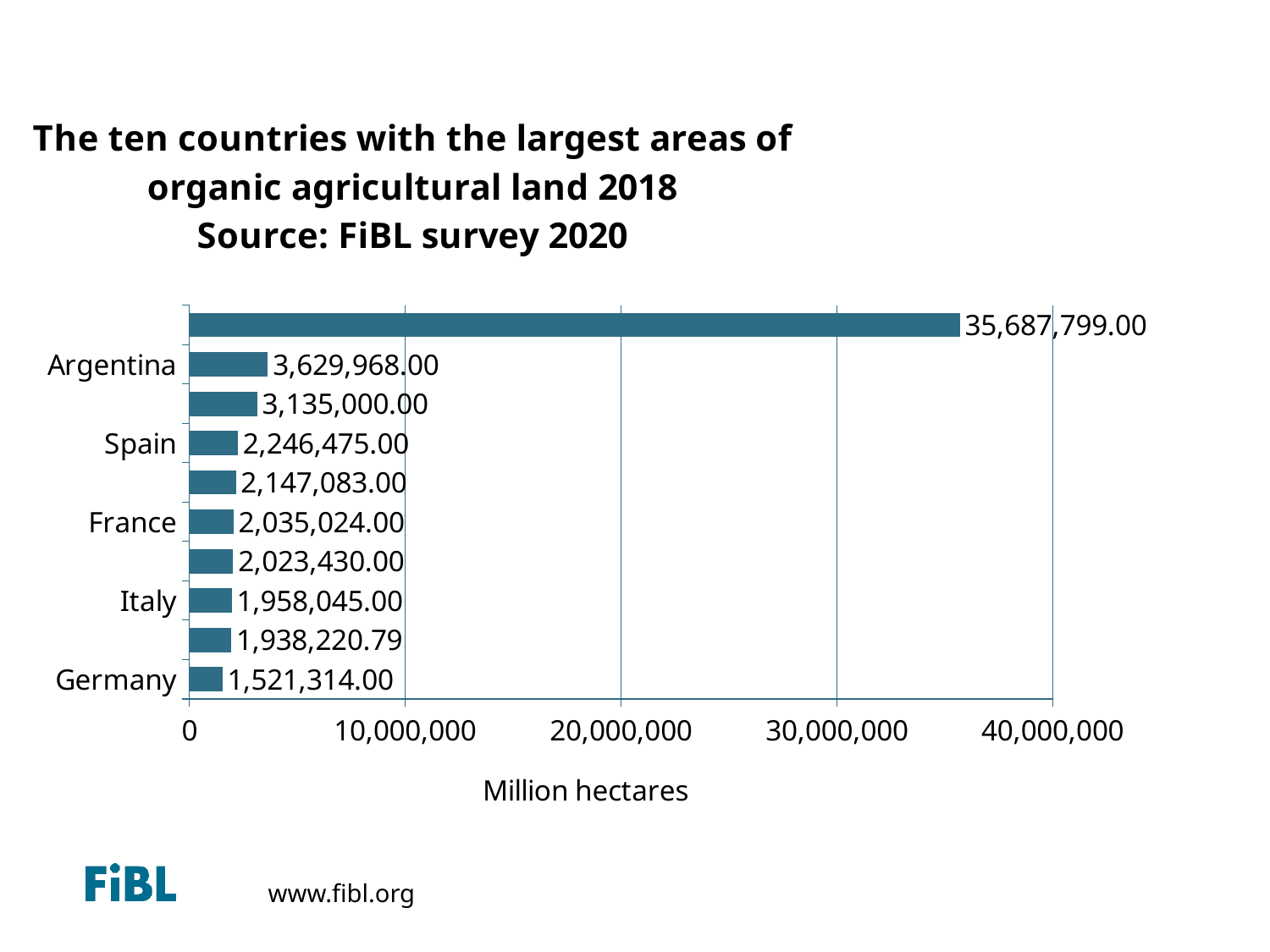
What is the value shown for France? 2,035,024.00 What is the value shown for Spain? 2,246,475.00 Which labelled country has the lowest value? Germany Is the value for Argentina greater or less than 10,000,000? less What is the difference between the values for Italy and Germany? 436,731.00 What is the difference between the values for Argentina and Spain? 1,383,493.00 Which has a larger value, Argentina or Spain? Argentina What kind of chart is shown on the slide? bar chart What is the value shown for Italy? 1,958,045.00 What is the value shown for Argentina? 3,629,968.00 How many bars are plotted in the chart? 10 What is the value shown for Germany? 1,521,314.00